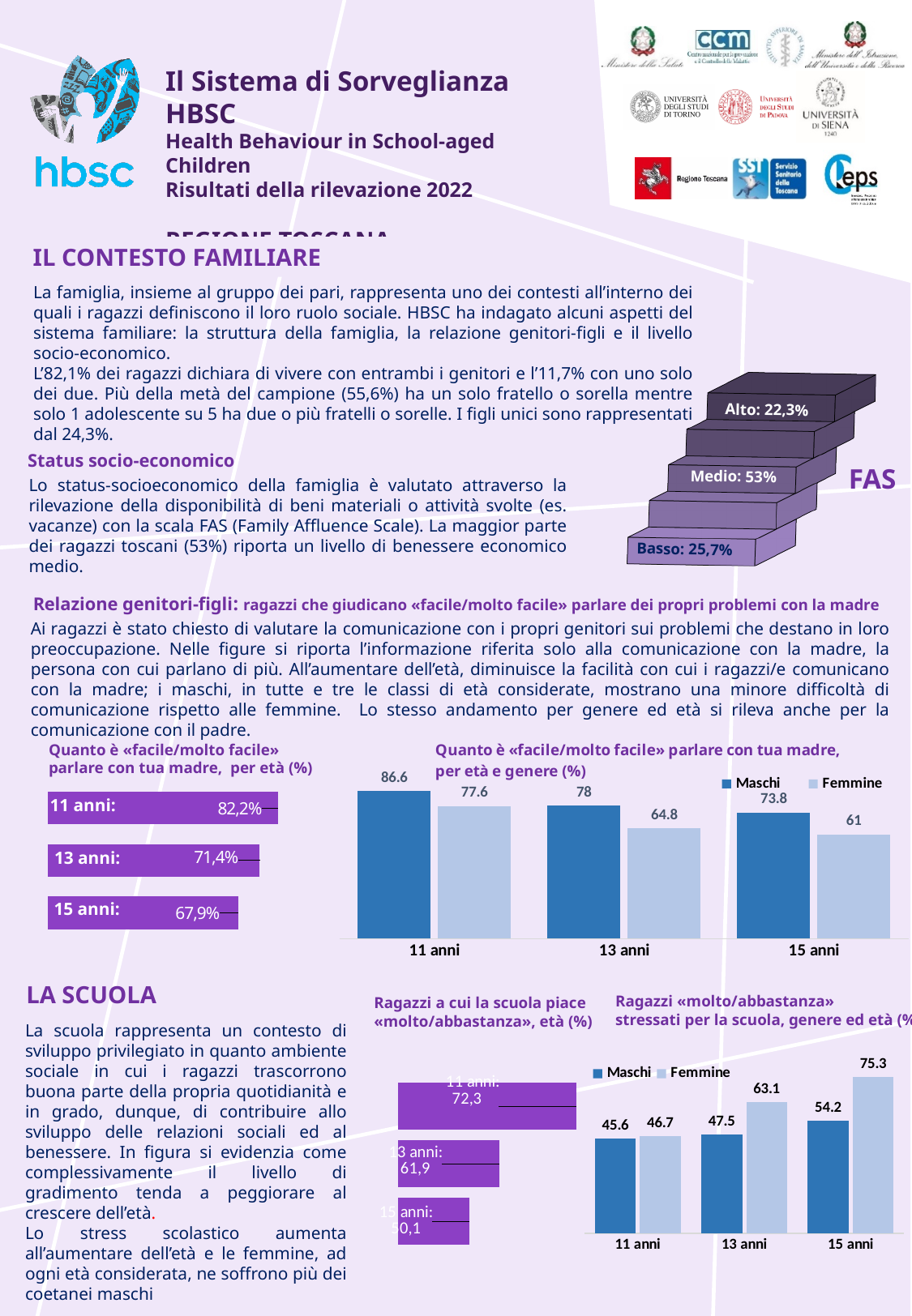
In the chart 'Ragazzi «molto/abbastanza» stressati per la scuola, genere ed età (%)', which is larger at 15 anni, Maschi or Femmine? Femmine In the FAS chart, what percentage of students report a 'Medio' level? 53% In the chart 'Quanto è «facile/molto facile» parlare con tua madre, per età (%)', which age group has the lowest value? 15 anni In the chart 'Quanto è «facile/molto facile» parlare con tua madre, per età e genere (%)', what is the value for Femmine at 15 anni? 61 In the chart 'Quanto è «facile/molto facile» parlare con tua madre, per età e genere (%)', what is the difference between Maschi and Femmine at 13 anni? 13.2 In the chart 'Ragazzi a cui la scuola piace «molto/abbastanza», età (%)', what is the value for 11 anni? 72,3 In the chart 'Quanto è «facile/molto facile» parlare con tua madre, per età e genere (%)', how many series does the legend list? 2 In the chart 'Quanto è «facile/molto facile» parlare con tua madre, per età (%)', what is the value for 13 anni? 71,4% In the chart 'Ragazzi «molto/abbastanza» stressati per la scuola, genere ed età (%)', which bar has the highest value? Femmine, 15 anni (75.3) In the chart 'Quanto è «facile/molto facile» parlare con tua madre, per età e genere (%)', what is the value for Maschi at 11 anni? 86.6 In the chart 'Ragazzi «molto/abbastanza» stressati per la scuola, genere ed età (%)', what is the value for Femmine at 13 anni? 63.1 In the chart 'Quanto è «facile/molto facile» parlare con tua madre, per età e genere (%)', do the Maschi values rise or fall as age increases? fall